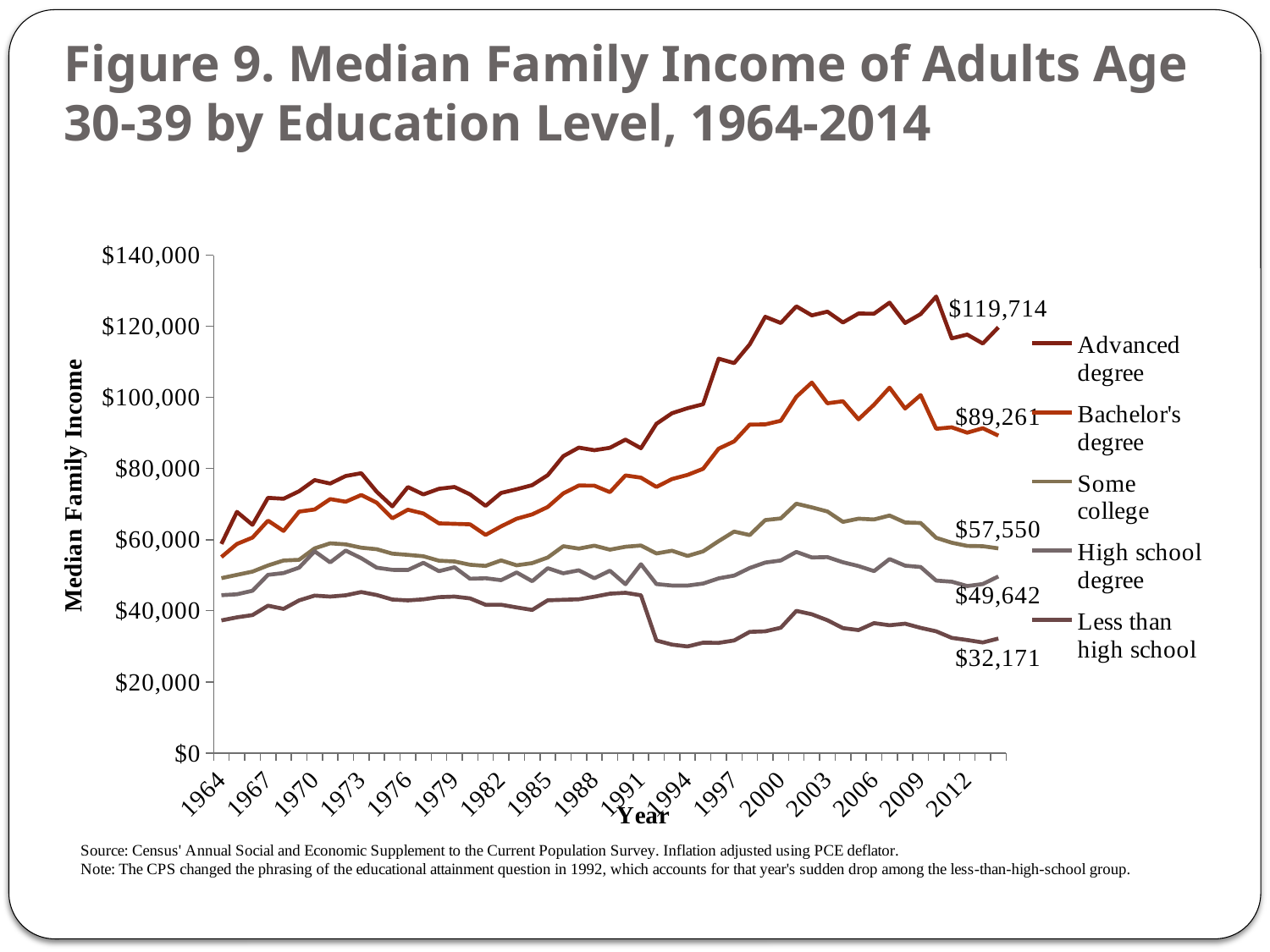
How many series does the legend list? 5 What is the 2014 median family income for adults with a bachelor's degree? $89,261 What is the 2014 median family income for adults with less than high school? $32,171 What type of chart is shown on the slide? Line chart Which education level has the lowest median family income in 2014? Less than high school Which education level has the highest median family income in 2014? Advanced degree Does the median family income for advanced degree holders generally rise or fall from 1964 to 2014? rise What is the 2014 median family income for adults with an advanced degree? $119,714 What is the 2014 median family income for adults with some college? $57,550 Is the 2014 median family income for high school degree holders greater or less than that for some college? less What is the difference between the 2014 median family income of advanced degree holders and bachelor's degree holders? $30,453 Is the median family income for the less than high school group in 1994 greater or less than $40,000? less